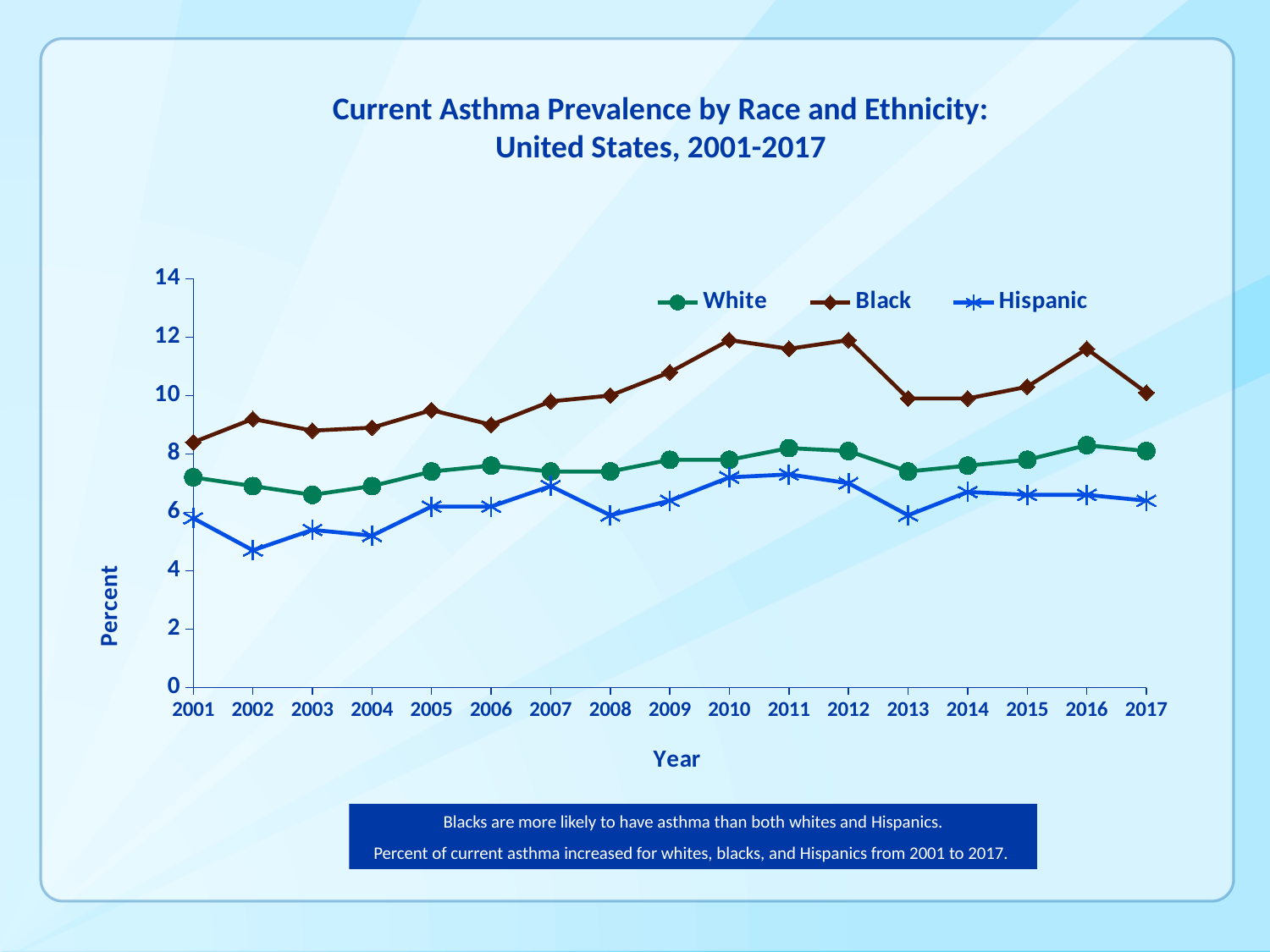
Does the Black series rise or fall from 2012 to 2013? Fall Which is larger in 2002, the value for White or the value for Hispanic? White Is the value for Hispanic in 2002 greater or less than 6? less Is the value for White in 2001 greater or less than 6? greater How many series does the legend list? 3 What is the title of the chart? Current Asthma Prevalence by Race and Ethnicity: United States, 2001-2017 Which series has the highest asthma prevalence across all years? Black How many years are plotted along the x axis? 17 What kind of chart is shown on the slide? Line chart In which year is the Hispanic value lowest? 2002 Is the value for Black in 2010 greater or less than 10? greater Which series has the lowest asthma prevalence across all years? Hispanic